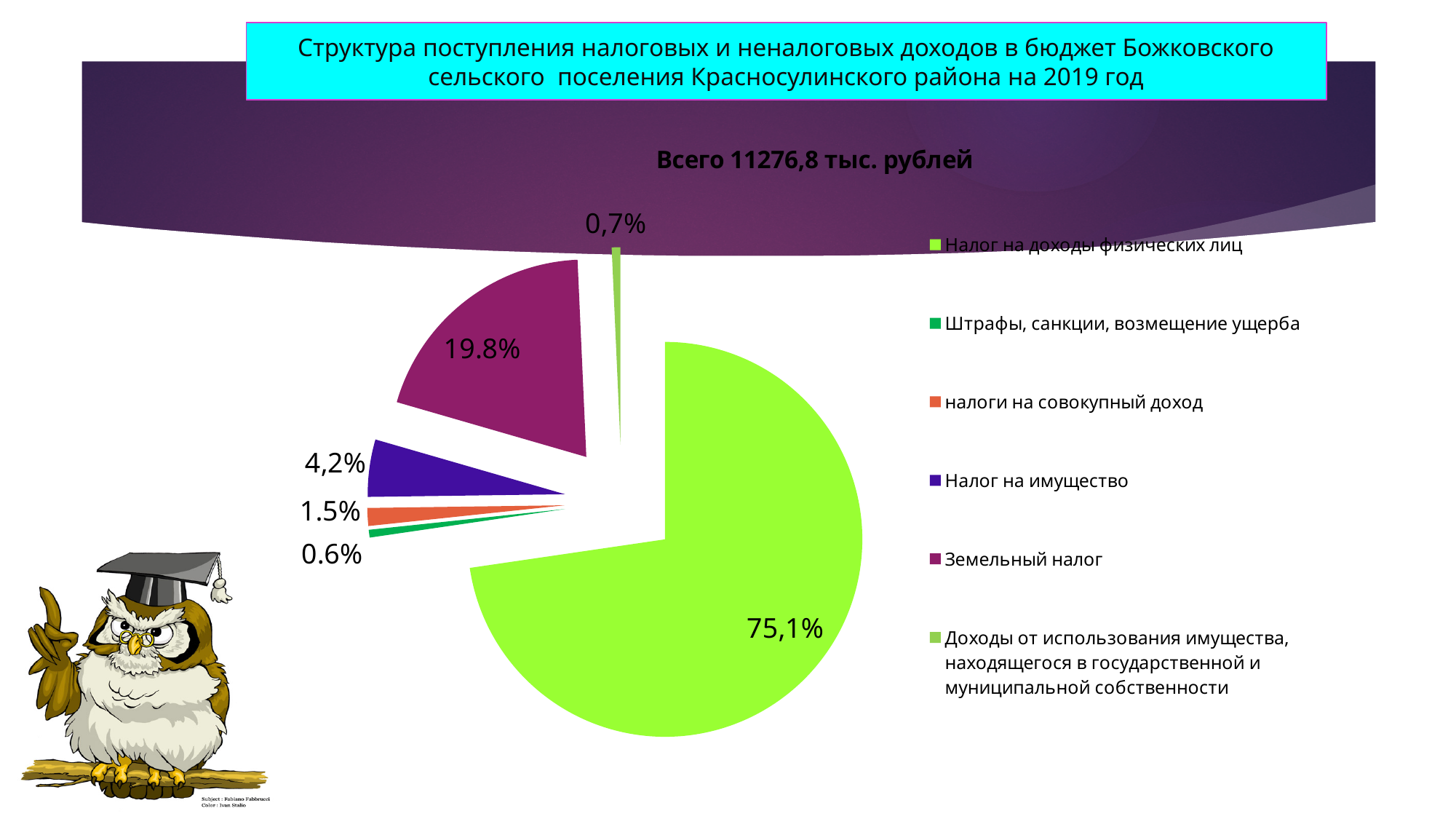
Which category has the largest share of the pie? Налог на доходы физических лиц What is the value shown for "Доходы от использования имущества, находящегося в государственной и муниципальной собственности"? 0,7% What share of the pie does "Налог на доходы физических лиц" have? 75,1% What is the value shown for "Штрафы, санкции, возмещение ущерба"? 0.6% What is the value shown for "Земельный налог"? 19.8% Which category has the smallest share of the pie? Штрафы, санкции, возмещение ущерба What is the value shown for "Налог на имущество"? 4,2% How many categories does the legend list? 6 What total amount is stated above the pie chart? Всего 11276,8 тыс. рублей Which is larger: the share for "Земельный налог" or the share for "Налог на имущество"? Земельный налог What is the value shown for "налоги на совокупный доход"? 1.5% What type of chart is shown on the slide? pie chart